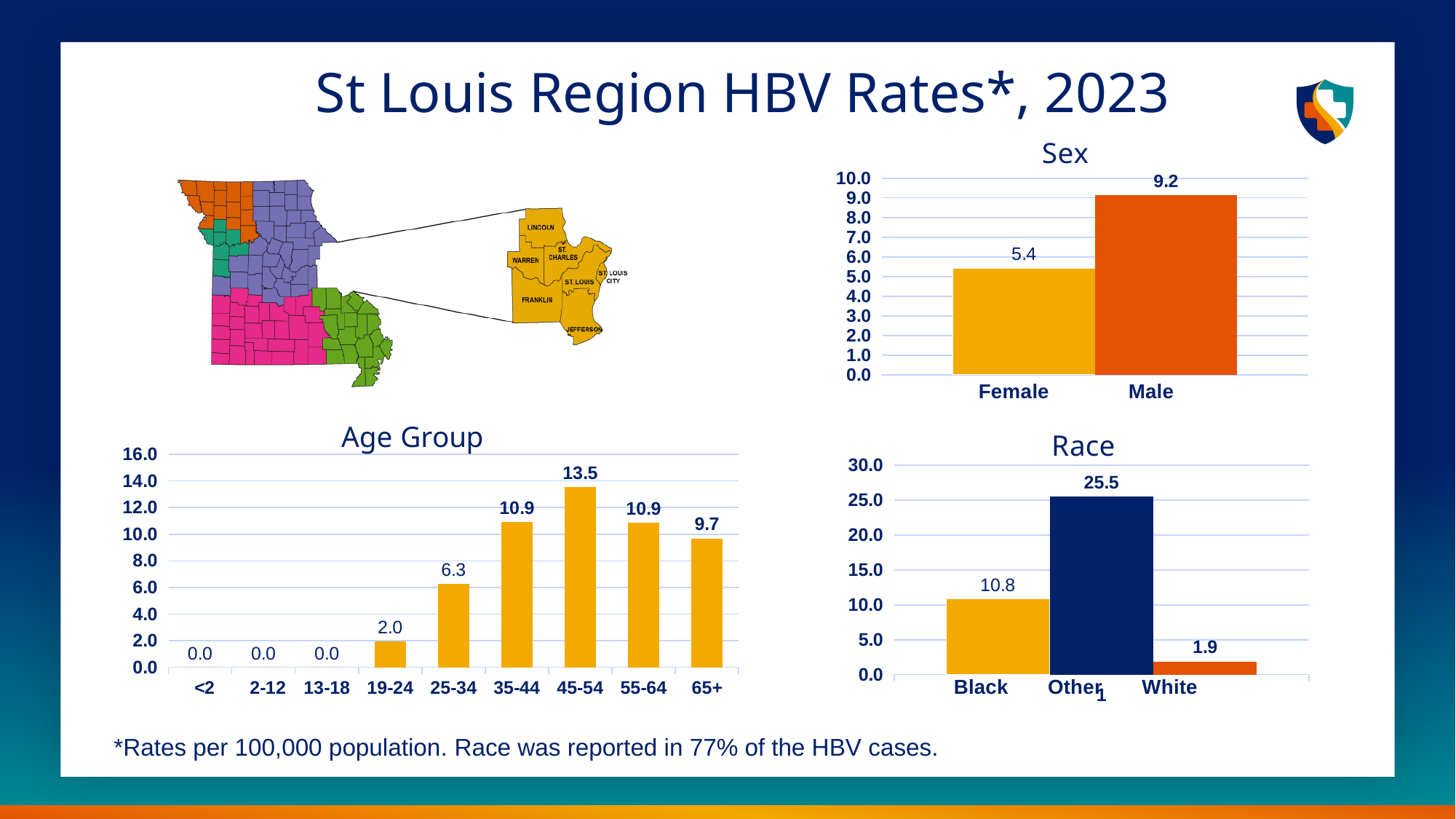
What type of chart is the Race chart? Bar chart In the Age Group chart, how many age groups have a rate of 0.0? 3 In the Sex chart, what is the difference between the Male and Female rates? 3.8 In the Age Group chart, how many age group categories are shown on the x axis? 9 In the Age Group chart, what is the rate for the 25-34 age group? 6.3 In the Age Group chart, which age group has the highest rate? 45-54 In the Race chart, what is the difference between the rates for Other and Black? 14.7 In the Sex chart, what is the HBV rate for Male? 9.2 In the Race chart, which race category has the lowest rate? White In the Race chart, which race category has the highest rate? Other In the Age Group chart, what is the rate for the 65+ age group? 9.7 In the Sex chart, what is the HBV rate for Female? 5.4